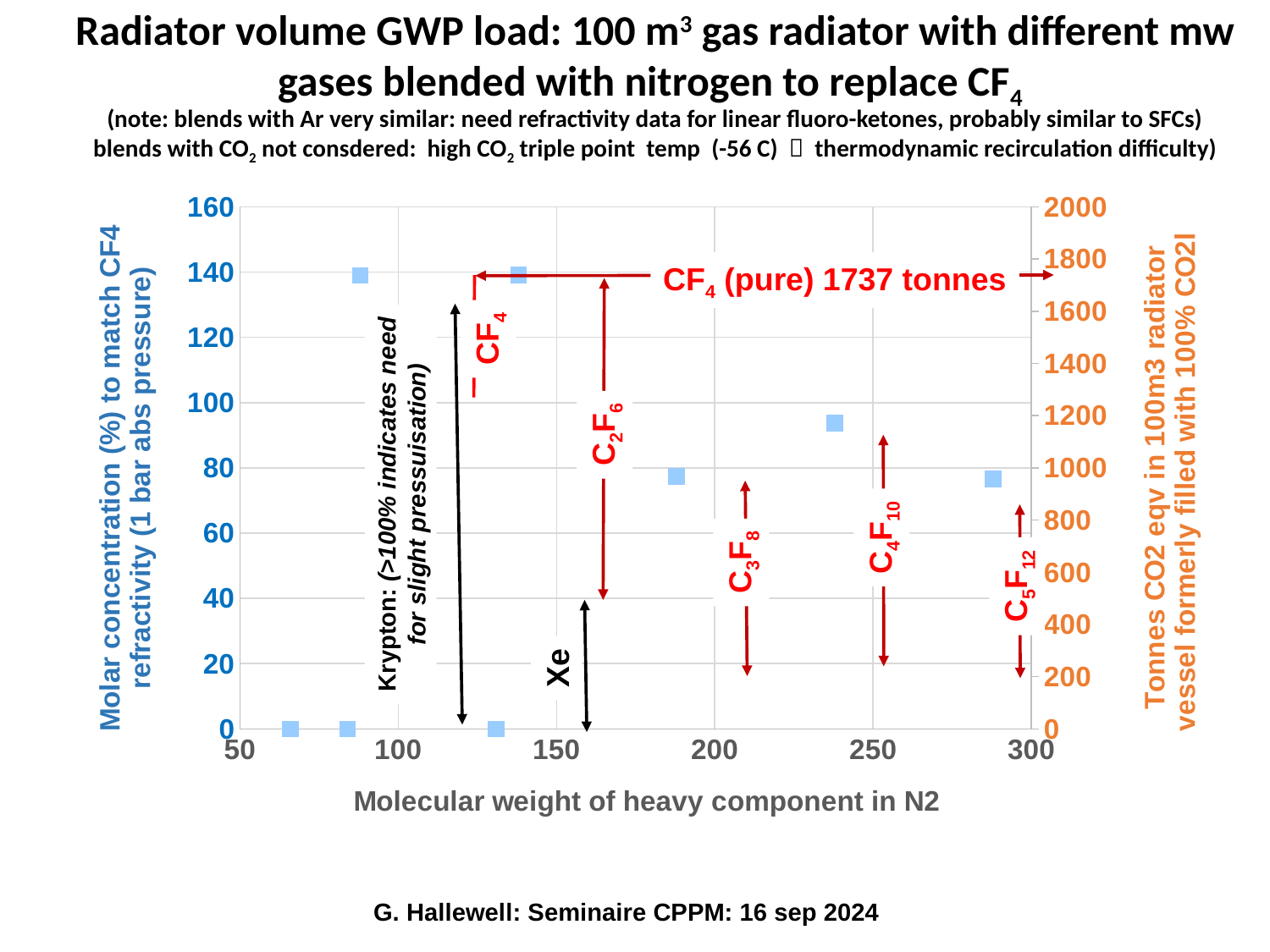
How many plotted points lie above 100 on the left axis? 2 Is the value of the highest plotted point greater or less than 120 on the left axis? greater How many plotted points lie at 0 on the left axis? 3 According to the annotation on the chart, how many tonnes of CO2 equivalent does pure CF4 correspond to? 1737 tonnes Is the value of the plotted point near molecular weight 190 greater or less than 100 on the left axis? less Is the value of the plotted point near molecular weight 240 greater or less than 80 on the left axis? greater What kind of chart is shown on the slide? scatter chart What is the lowest tick value shown on the x axis of the chart? 50 What is the highest tick value shown on the right y axis of the chart? 2000 How many blue data points are plotted on the chart? 8 What is the highest tick value shown on the left y axis of the chart? 160 What is the title of the x axis of the chart? Molecular weight of heavy component in N2